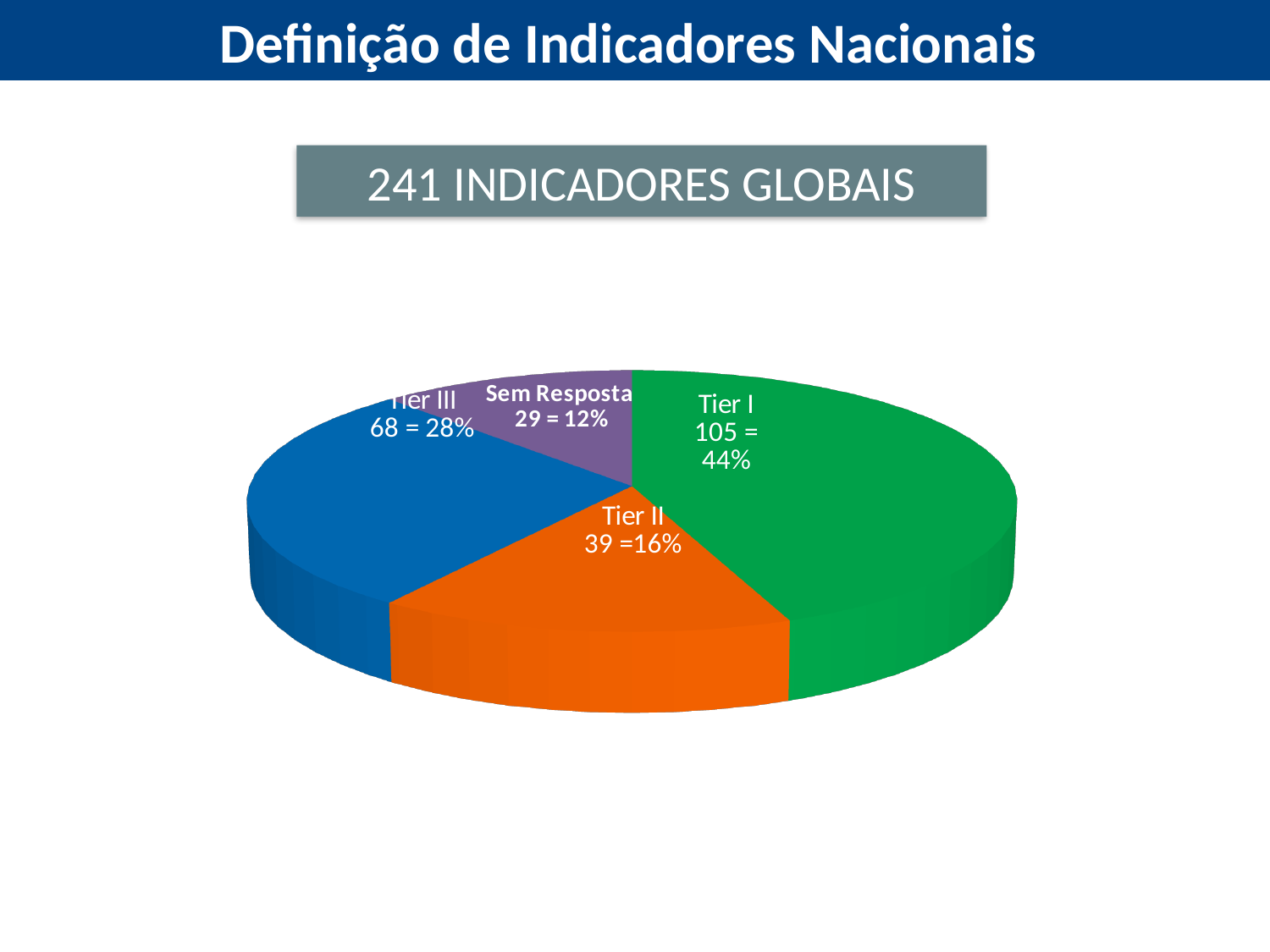
What is the total number of global indicators stated on the slide? 241 How many slices does the pie chart have? 4 Which slice is the smallest? Sem Resposta What percentage of the pie does Tier II represent? 16% Which slice is the largest? Tier I What colour is the Tier III slice? blue What kind of chart is shown on the slide? pie chart What is the count shown for Sem Resposta? 29 What is the count shown for Tier I? 105 What percentage of the pie does Tier III represent? 28% Which is larger, the count for Tier II or the count for Sem Resposta? Tier II What is the difference between the counts for Tier I and Tier III? 37